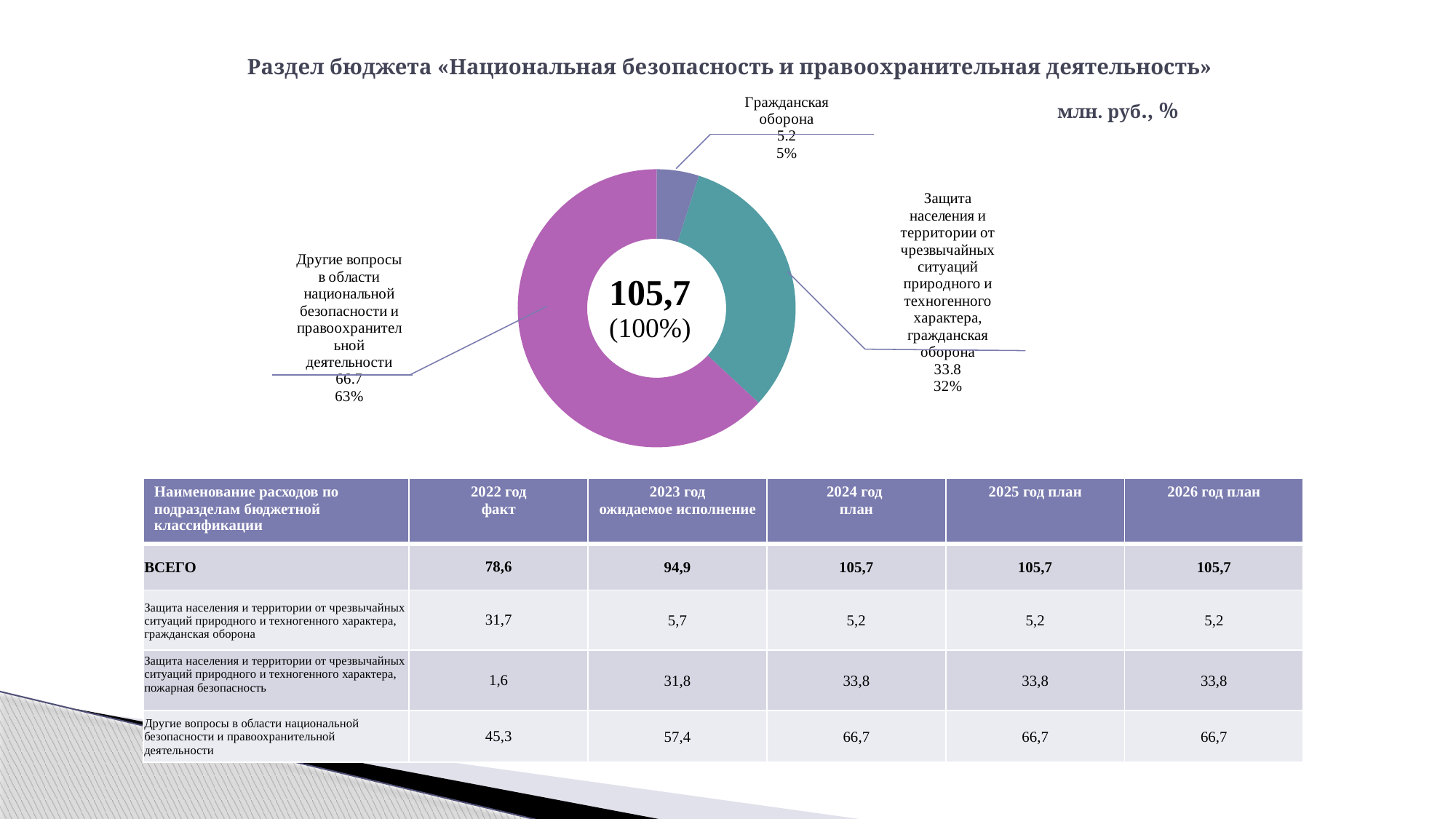
What is the value shown for the slice "Защита населения и территории от чрезвычайных ситуаций природного и техногенного характера, гражданская оборона"? 33.8 What total value is shown in the centre of the donut chart? 105,7 (100%) What is the value shown for the slice "Гражданская оборона"? 5.2 Which slice of the pie chart is the largest? Другие вопросы в области национальной безопасности и правоохранительной деятельности What is the value shown for the slice "Другие вопросы в области национальной безопасности и правоохранительной деятельности"? 66.7 How many slices does the pie chart have? 3 What percentage share does the slice "Гражданская оборона" have? 5% What is the difference between the values of the "Другие вопросы..." slice (66.7) and the "Защита населения..." slice (33.8)? 32.9 What percentage share does the slice "Защита населения и территории от чрезвычайных ситуаций природного и техногенного характера, гражданская оборона" have? 32% What kind of chart is shown on the slide? Pie chart (donut) What percentage share does the slice "Другие вопросы в области национальной безопасности и правоохранительной деятельности" have? 63% Which slice of the pie chart is the smallest? Гражданская оборона